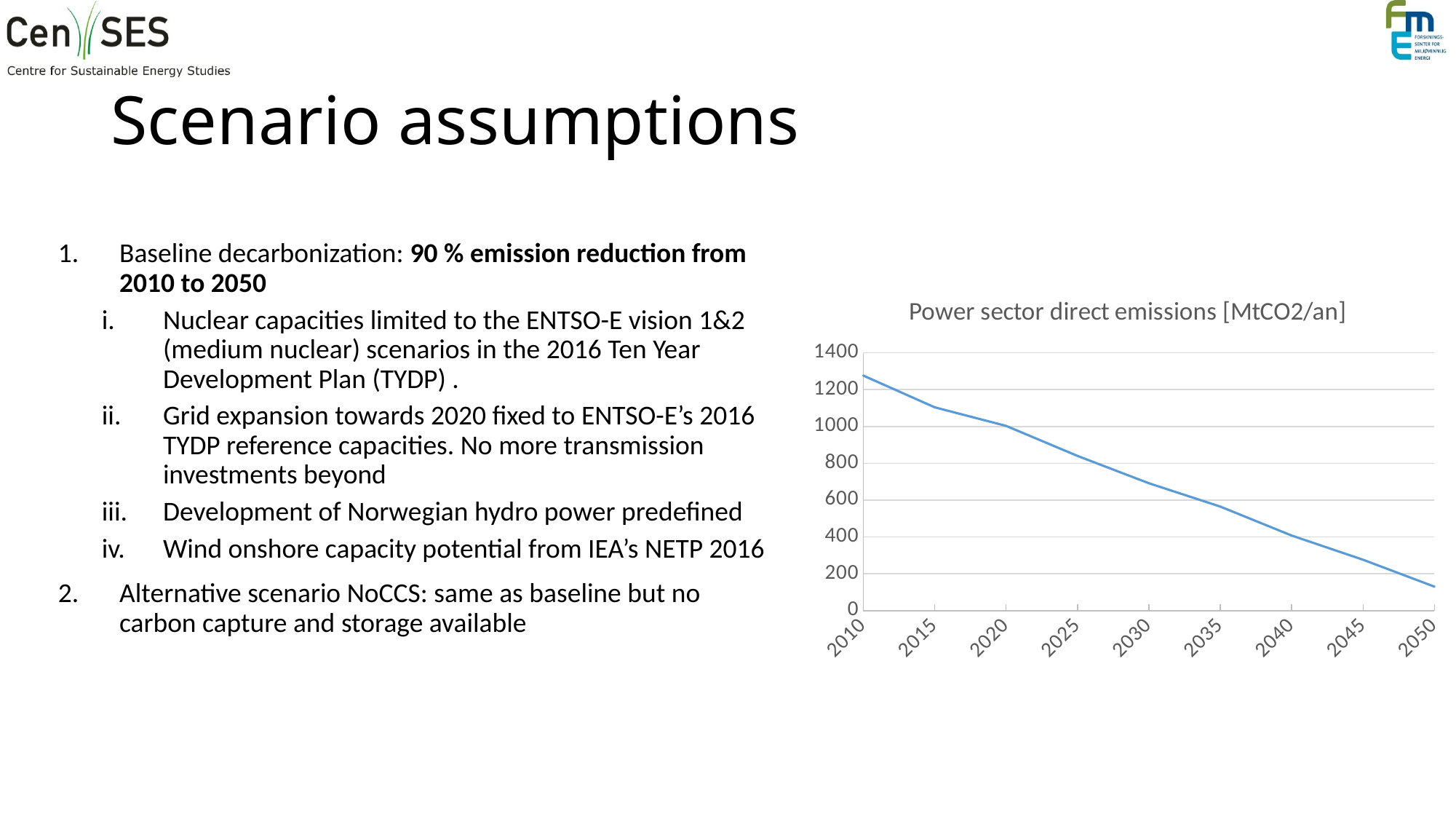
Is the value for 2015 greater or less than 1000? greater In which year shown on the x axis are power sector direct emissions lowest? 2050 Is the value for 2050 greater or less than 200? less What kind of chart is shown on the slide? line chart Which year has the larger value, 2020 or 2035? 2020 In which year shown on the x axis are power sector direct emissions highest? 2010 What is the title of the chart? Power sector direct emissions [MtCO2/an] Is the value for 2010 greater or less than 1200? greater How many year labels are shown on the x axis? 9 Do the power sector direct emissions rise or fall from 2010 to 2050? fall